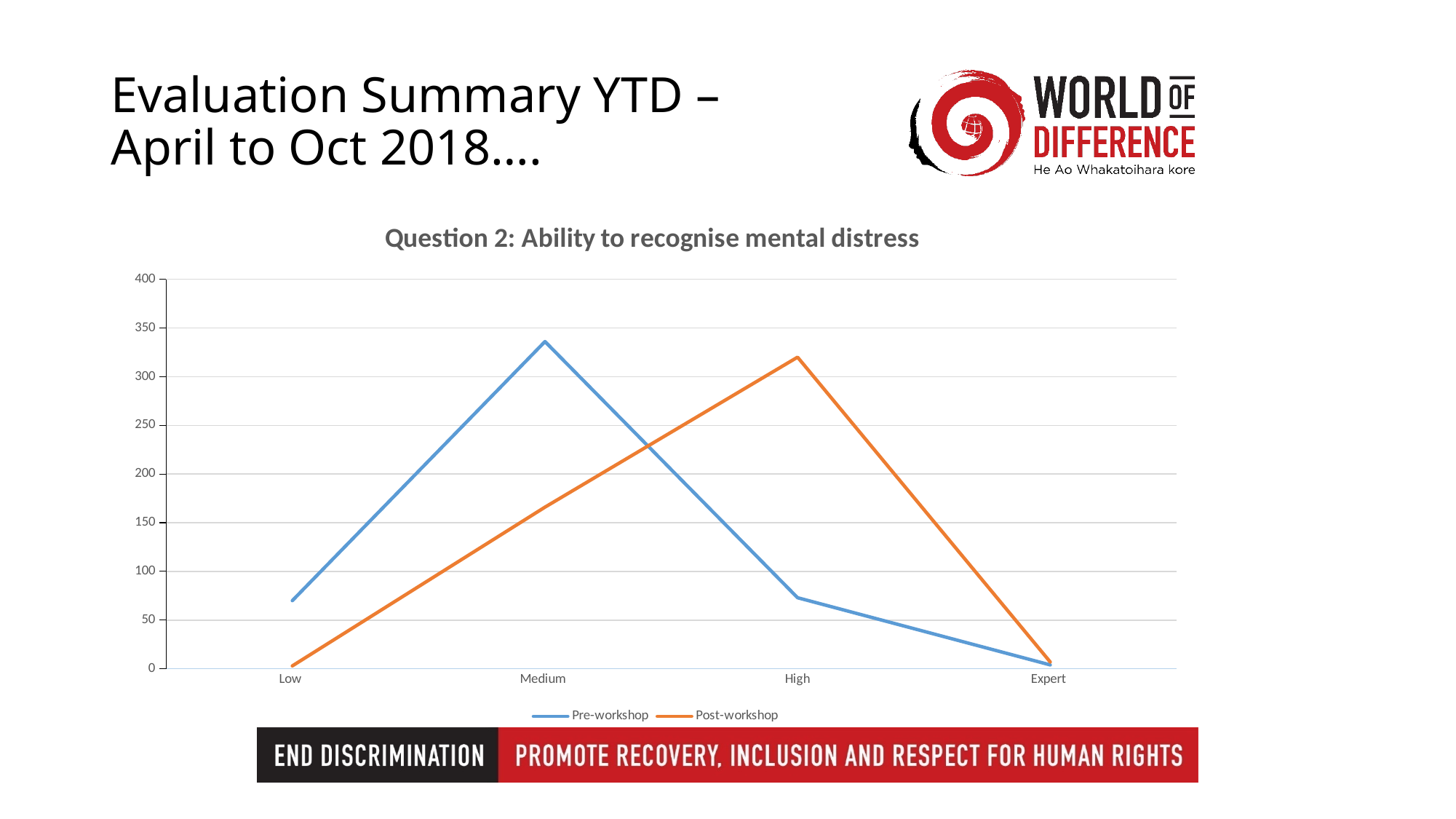
Does the Post-workshop series rise or fall from Low to High? rise What kind of chart is shown on the slide? Line chart At which category does the Pre-workshop series reach its highest value? Medium At the High category, which series has the larger value, Pre-workshop or Post-workshop? Post-workshop At which category is the Pre-workshop series at its lowest value? Expert How many series does the chart's legend list? 2 Is the Pre-workshop value for Medium greater or less than 300? greater At which category does the Post-workshop series reach its highest value? High Which series is drawn in orange? Post-workshop At the Medium category, which series has the larger value, Pre-workshop or Post-workshop? Pre-workshop What is the title of the chart? Question 2: Ability to recognise mental distress How many categories are shown on the x axis of the chart? 4